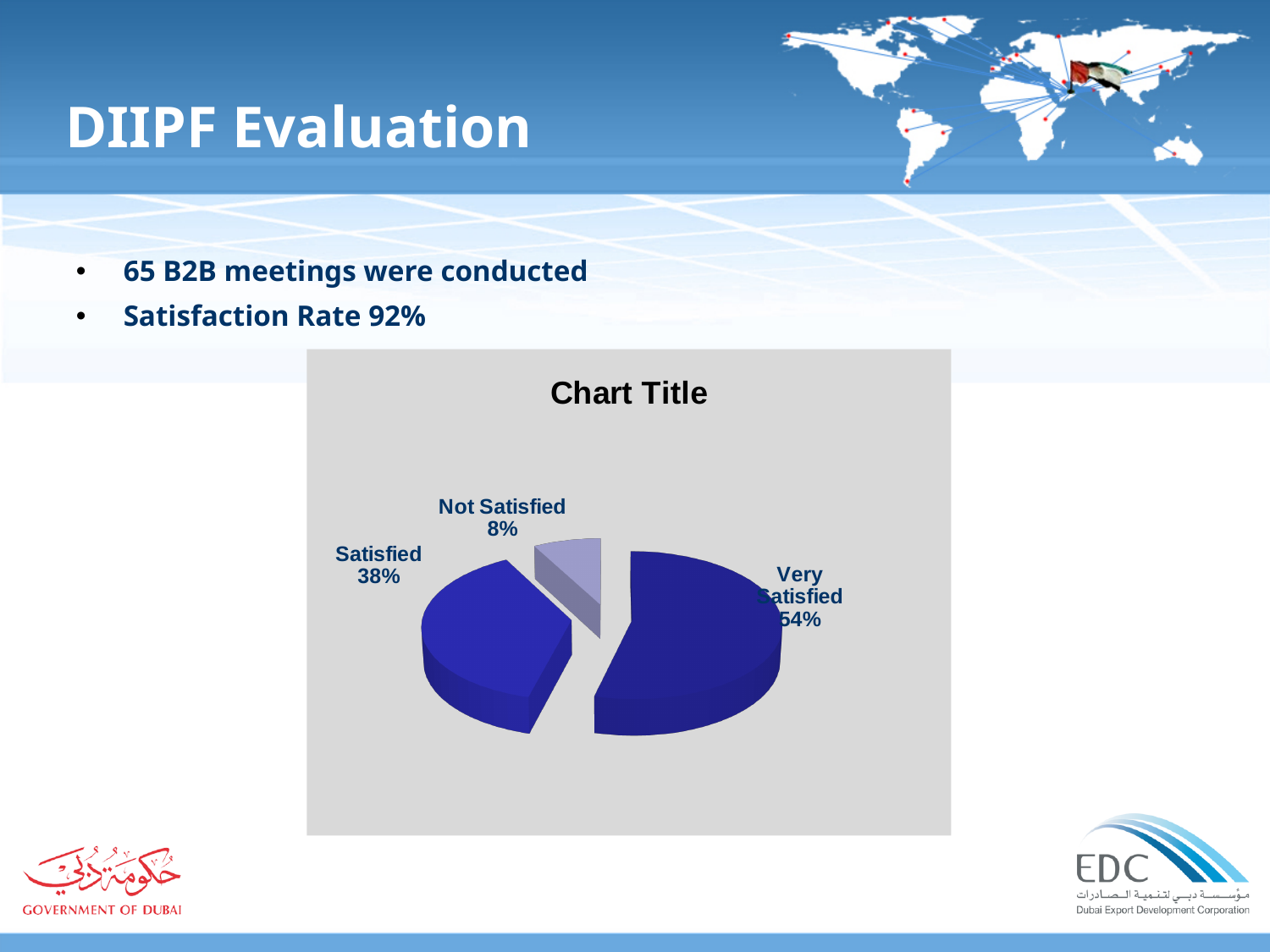
What share of the pie is labelled Not Satisfied? 8% What is the difference in percentage points between the Very Satisfied and Satisfied slices? 16% Which slice of the pie is the smallest? Not Satisfied What is the difference in percentage points between the Satisfied and Not Satisfied slices? 30% What share of the pie is labelled Satisfied? 38% What is the combined share of the Very Satisfied and Satisfied slices? 92% What kind of chart is shown on the slide? pie chart What is the title shown above the pie chart? Chart Title Which is larger, the Satisfied slice or the Not Satisfied slice? Satisfied Which slice of the pie is the largest? Very Satisfied How many slices does the pie chart have? 3 What share of the pie is labelled Very Satisfied? 54%